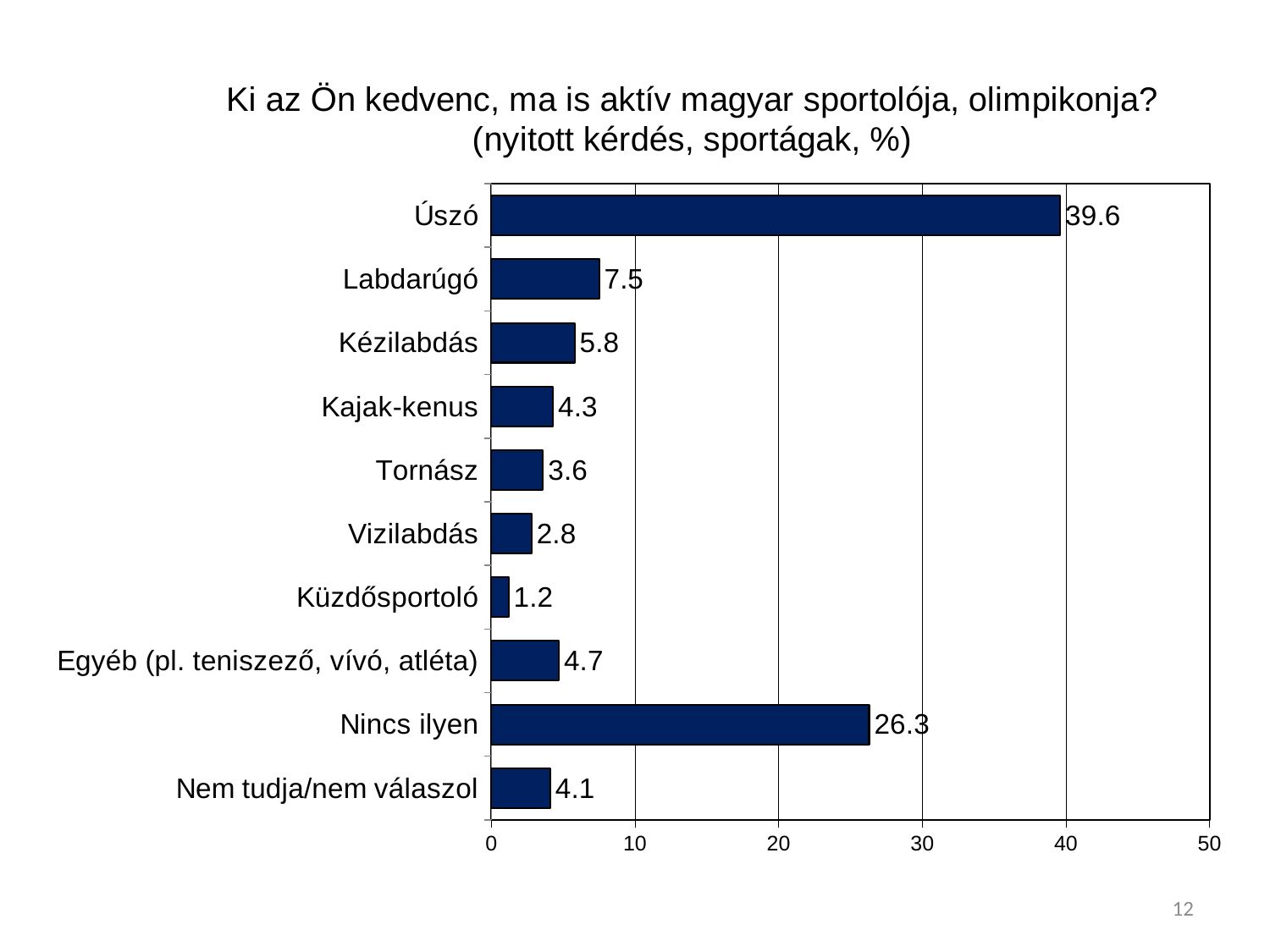
Which is larger, the value for Tornász or the value for Vizilabdás? Tornász What is the value for Kajak-kenus? 4.3 What is the value for Nem tudja/nem válaszol? 4.1 Which category has the highest value? Úszó What is the maximum value shown on the horizontal axis? 50 Which category has the lowest value? Küzdősportoló What is the difference between the values for Úszó and Nincs ilyen? 13.3 What is the value for Nincs ilyen? 26.3 What is the value for Úszó? 39.6 How many categories are shown in the chart? 10 What kind of chart is shown on the slide? Bar chart What is the difference between the values for Labdarúgó and Kézilabdás? 1.7